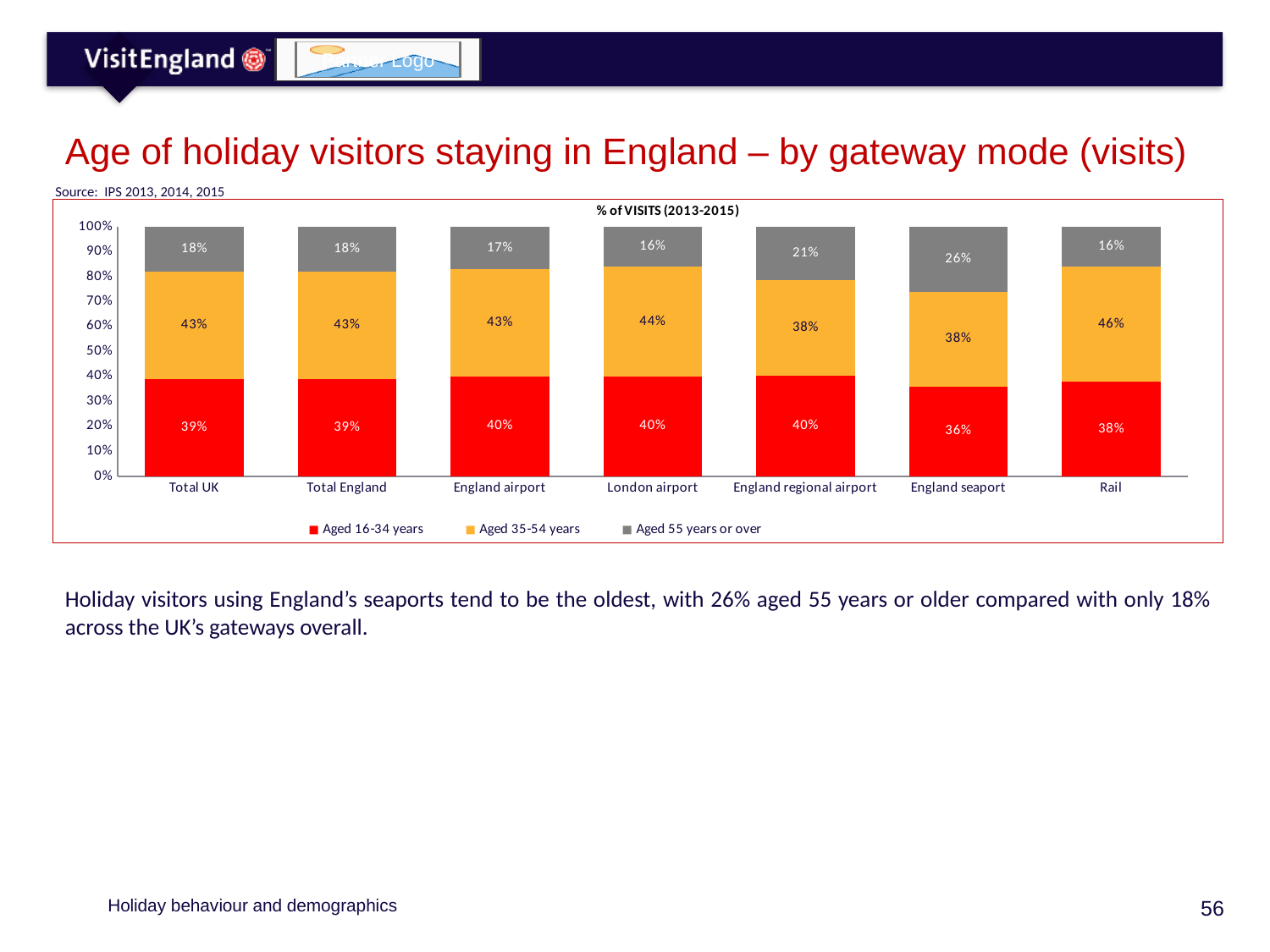
Which colour represents visitors aged 16-34 years in the chart? Red What is the difference between the share of visitors aged 55 years or over for England seaport and for Total UK? 8 percentage points What is the total of the stacked bar for England regional airport? 99% Which gateway mode has the lowest share of visitors aged 16-34 years? England seaport What percentage of holiday visitors arriving via England seaport are aged 55 years or over? 26% How many series does the legend list? 3 Which is larger: the share of visitors aged 35-54 years for Rail or for England regional airport? Rail What percentage of holiday visitors arriving by Rail are aged 35-54 years? 46% What kind of chart is shown on the slide? Stacked bar chart Which gateway mode has the highest share of visitors aged 55 years or over? England seaport How many gateway mode categories are shown on the x axis? 7 What percentage of holiday visitors arriving via London airport are aged 16-34 years? 40%